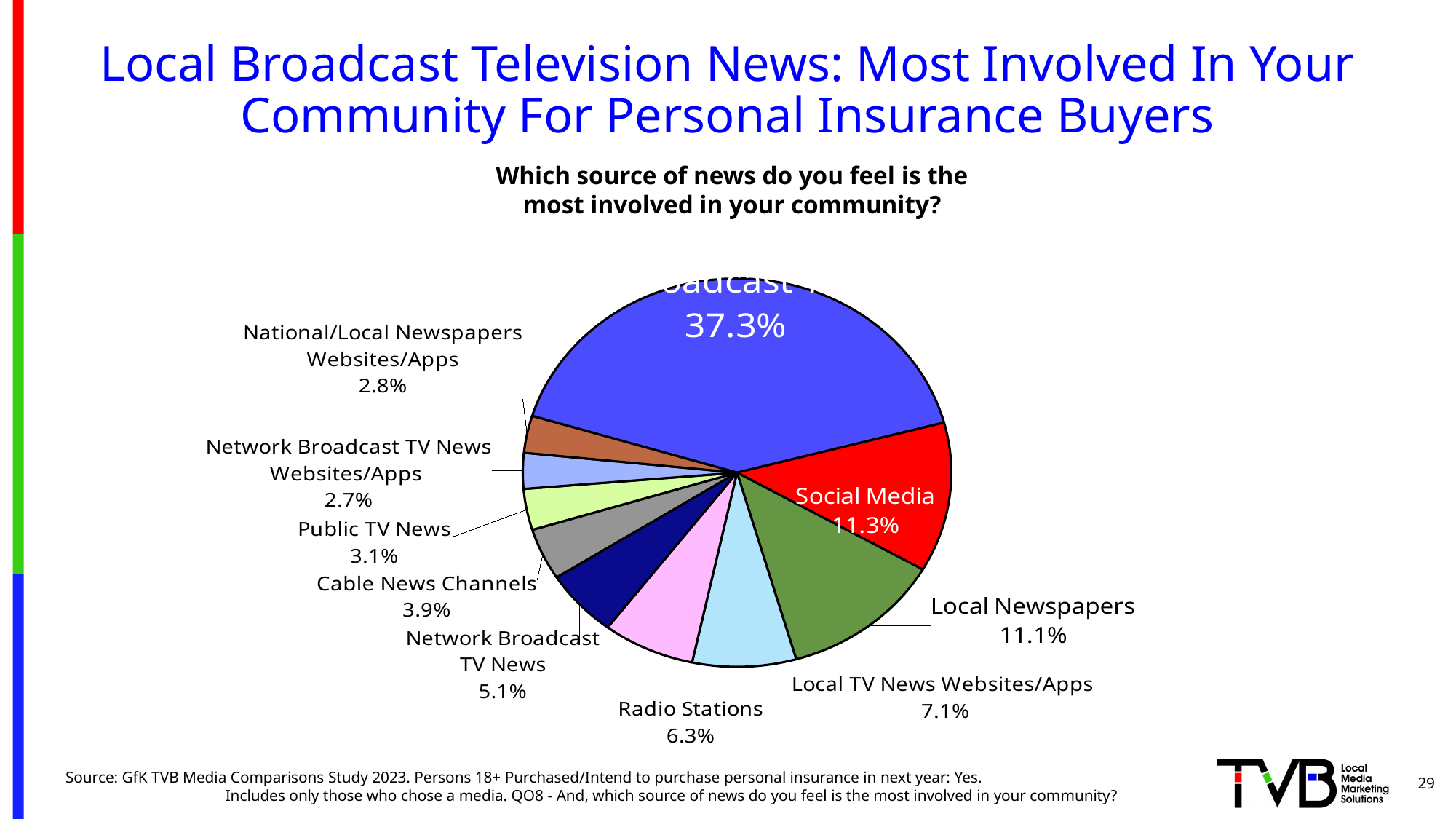
What colour is the Social Media slice? red What share of respondents chose Social Media as the news source most involved in their community? 11.3% What percentage is shown for Radio Stations? 6.3% Which has a larger share: Radio Stations or Local TV News Websites/Apps? Local TV News Websites/Apps What percentage is shown for Local Newspapers? 11.1% What is the percentage of the largest slice in the pie chart? 37.3% What kind of chart is shown on the slide? pie chart What is the difference in percentage points between Social Media and Local Newspapers? 0.2% How many slices does the pie chart have? 10 Which category has the smallest slice in the pie chart? Network Broadcast TV News Websites/Apps What percentage is shown for Cable News Channels? 3.9% What percentage is shown for Public TV News? 3.1%